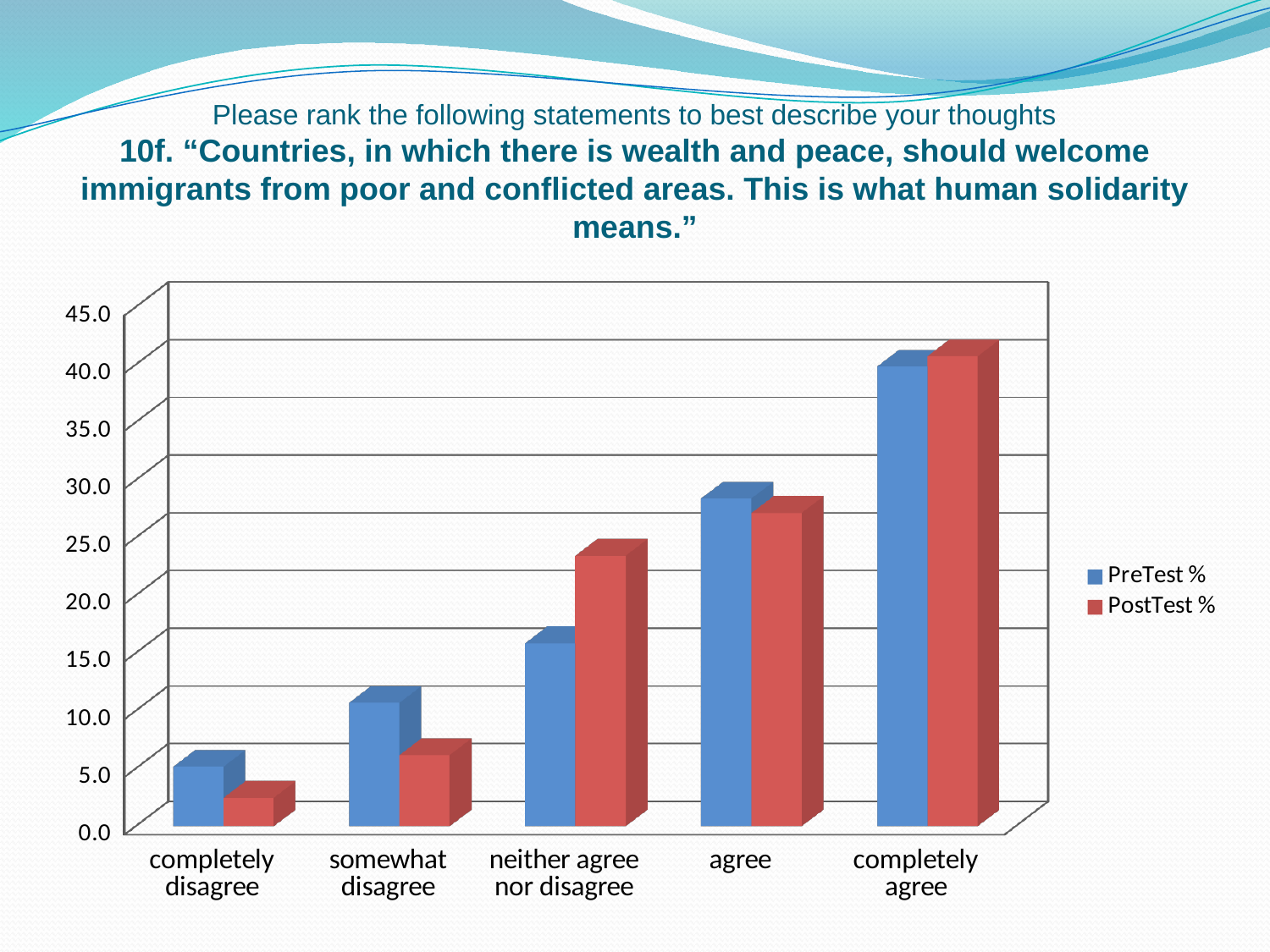
Is the PreTest % value for 'completely agree' greater or less than 35.0? greater Is the PostTest % value for 'neither agree nor disagree' greater or less than 20.0? greater For 'neither agree nor disagree', which is larger: PreTest % or PostTest %? PostTest % Do the PreTest % values rise or fall moving from 'completely disagree' to 'completely agree' along the x axis? rise Which category has the highest PreTest % value? completely agree What kind of chart is shown on the slide? bar chart Is the PreTest % value for 'completely disagree' greater or less than 10.0? less What colour are the PostTest % bars? red Which category has the lowest PostTest % value? completely disagree How many series does the legend list? 2 How many response categories are shown on the x axis? 5 For 'somewhat disagree', which is larger: PreTest % or PostTest %? PreTest %